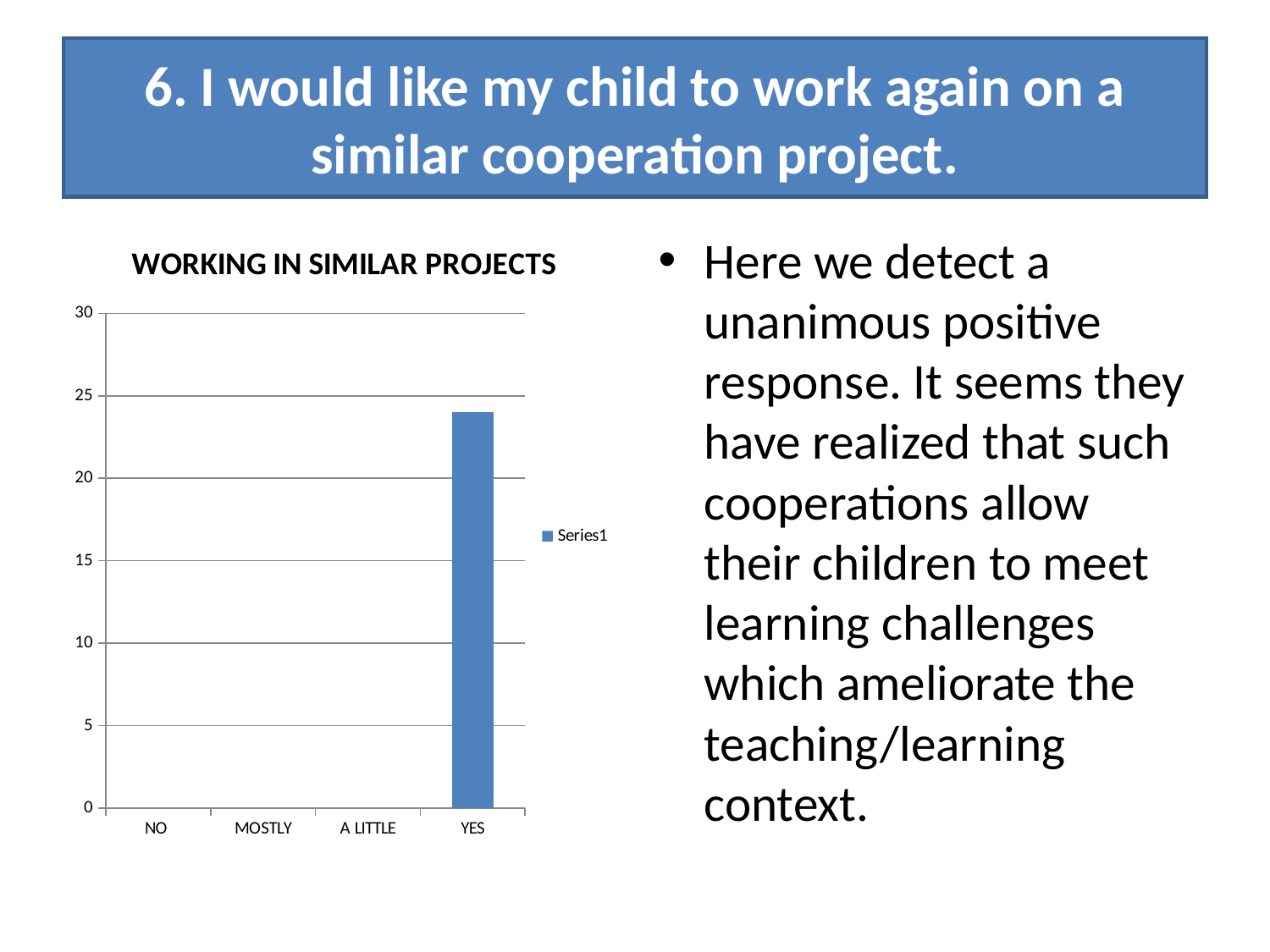
Which is larger, the value for YES or the value for NO? YES What is the name of the series shown in the chart legend? Series1 What is the title of the chart? WORKING IN SIMILAR PROJECTS How many series does the chart legend list? 1 Is the value for A LITTLE greater or less than 5? less Is the value for YES greater or less than 20? greater Which is larger, the value for MOSTLY or the value for YES? YES How many categories are shown on the x axis of the chart? 4 Which category has the highest value in the chart? YES Is the value for YES greater or less than 25? less What is the highest value shown on the vertical axis of the chart? 30 What kind of chart is shown on the slide? bar chart